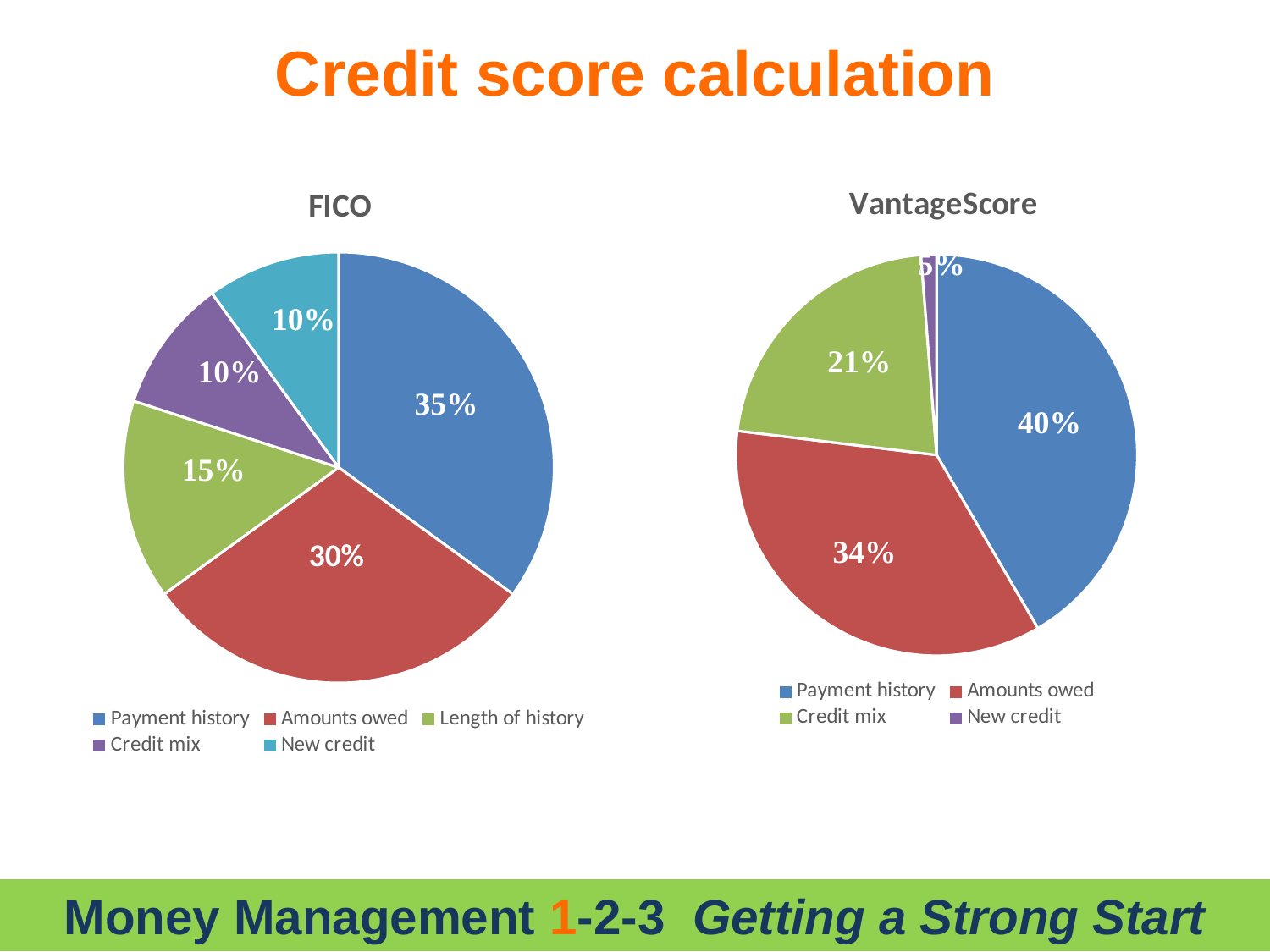
In the VantageScore chart, which category has the largest slice? Payment history In the VantageScore chart, which category has the smallest slice? New credit In the FICO chart, what share does Payment history have? 35% In the FICO chart, what share does Length of history have? 15% In the VantageScore chart, what share does Amounts owed have? 34% In the VantageScore chart, what share does Credit mix have? 21% Is the Payment history share larger in the FICO chart or the VantageScore chart? VantageScore How many categories does the VantageScore chart show? 4 How many categories does the FICO chart show? 5 In the FICO chart, what is the difference between the Payment history and Amounts owed shares? 5% In the FICO chart, which category has the largest slice? Payment history What kind of chart is the FICO chart? Pie chart